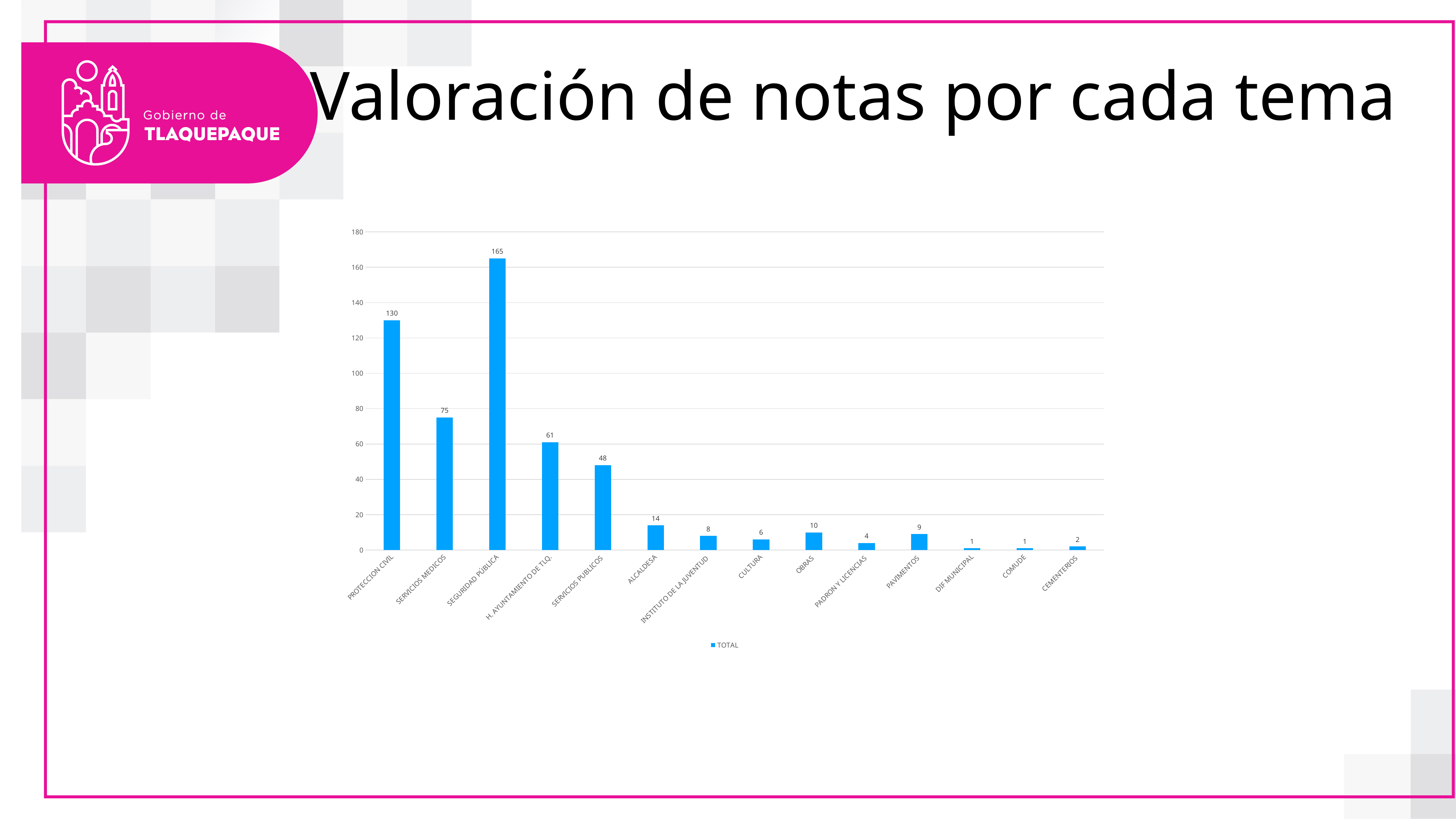
What is the value for ALCALDESA? 14 How many categories are shown on the x axis? 14 What kind of chart is shown on the slide? bar chart What is the value for H. AYUNTAMIENTO DE TLQ.? 61 What is the difference between the values for SEGURIDAD PÚBLICA and PROTECCION CIVIL? 35 Which category has the highest value? SEGURIDAD PÚBLICA Which is larger, the value for OBRAS or the value for PAVIMENTOS? OBRAS What is the value for PROTECCION CIVIL? 130 How many series does the legend list? 1 What is the value for SEGURIDAD PÚBLICA? 165 Is the value for SERVICIOS MEDICOS greater or less than 80? less What is the difference between the values for SERVICIOS MEDICOS and SERVICIOS PUBLICOS? 27